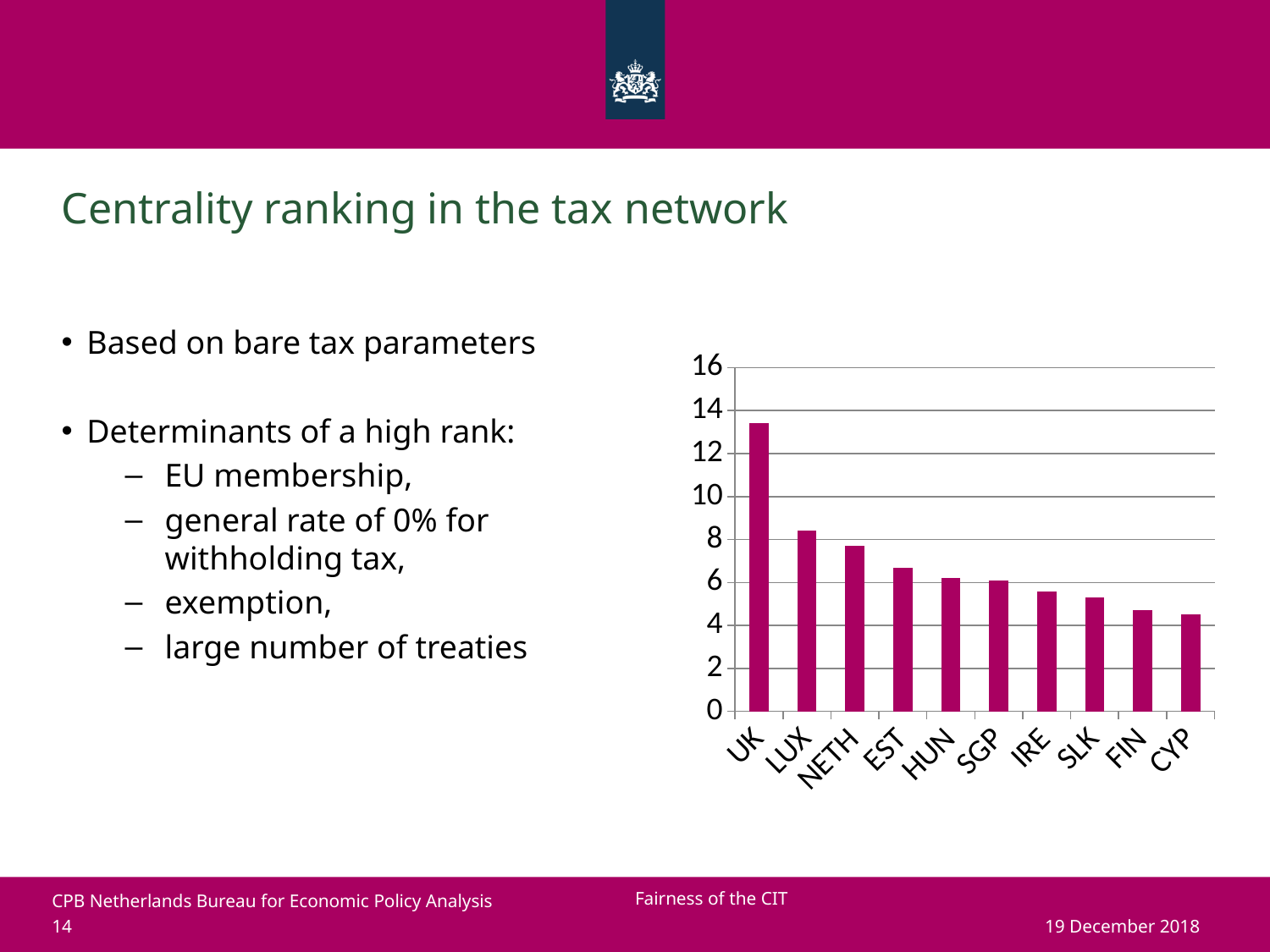
What is the title of the slide containing the chart? Centrality ranking in the tax network Is the value for NETH greater or less than 8? less Which has the larger value, FIN or NETH? NETH What kind of chart is shown on the slide? bar chart How many countries are shown on the x axis of the chart? 10 Is the value for CYP greater or less than 6? less Is the value for UK greater or less than 12? greater Which country has the highest bar in the chart? UK Which country has the lowest bar in the chart? CYP Which has the larger value, UK or LUX? UK Do the bar values rise or fall from left to right along the x axis? fall